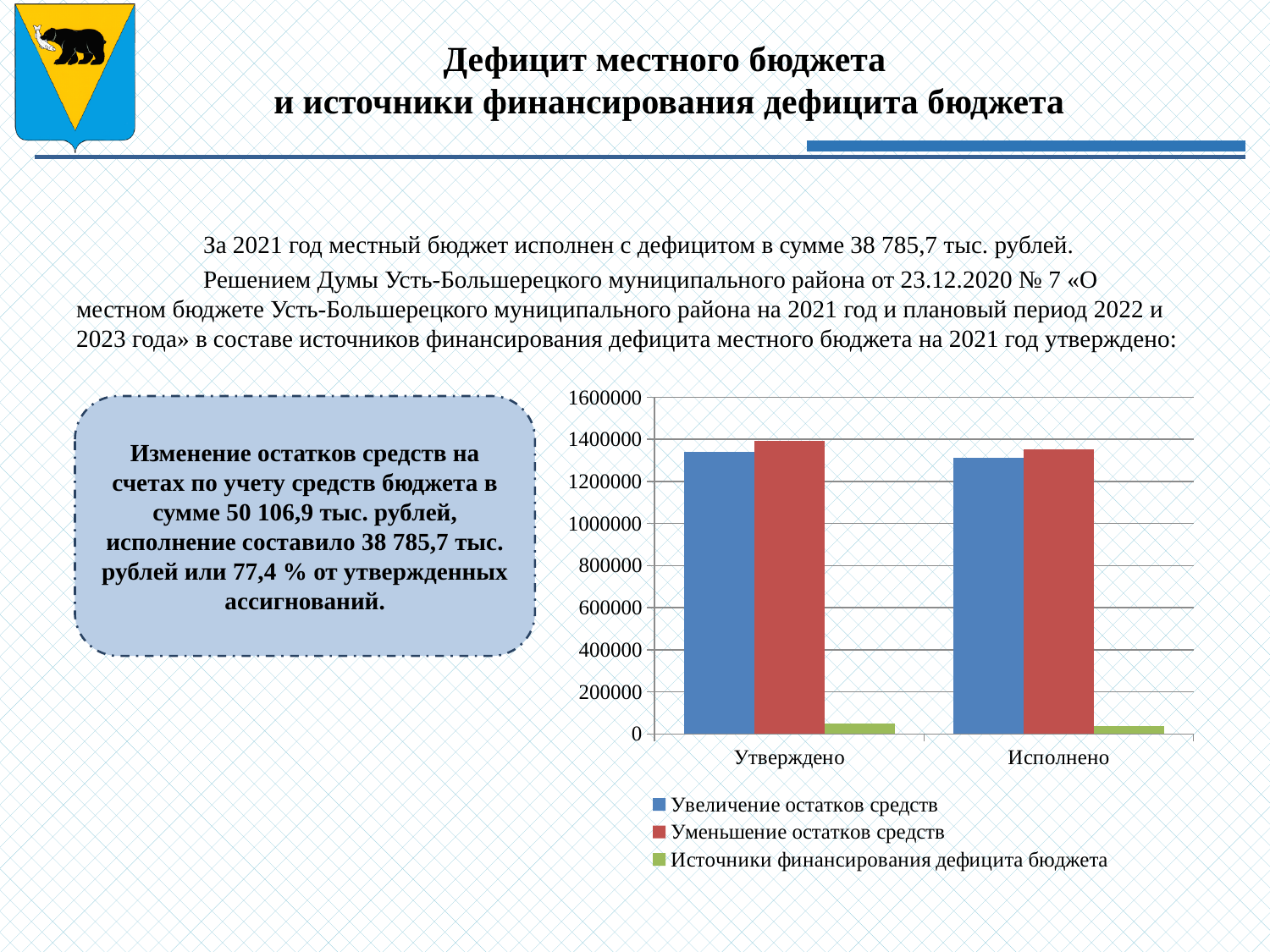
Is the value of Источники финансирования дефицита бюджета for Утверждено greater or less than 200000? less Which series has the highest value in the Утверждено category? Уменьшение остатков средств Is the value of Увеличение остатков средств for Утверждено greater or less than 1200000? greater How many series does the chart legend list? 3 For Уменьшение остатков средств, which category has the larger value: Утверждено or Исполнено? Утверждено Which series has the lowest value in the Исполнено category? Источники финансирования дефицита бюджета In the Утверждено category, which is larger: Увеличение остатков средств or Уменьшение остатков средств? Уменьшение остатков средств Is the value of Уменьшение остатков средств for Исполнено greater or less than 1400000? less What kind of chart is shown on the slide? bar chart How many categories are shown on the x axis of the chart? 2 What colour represents Источники финансирования дефицита бюджета in the chart legend? green